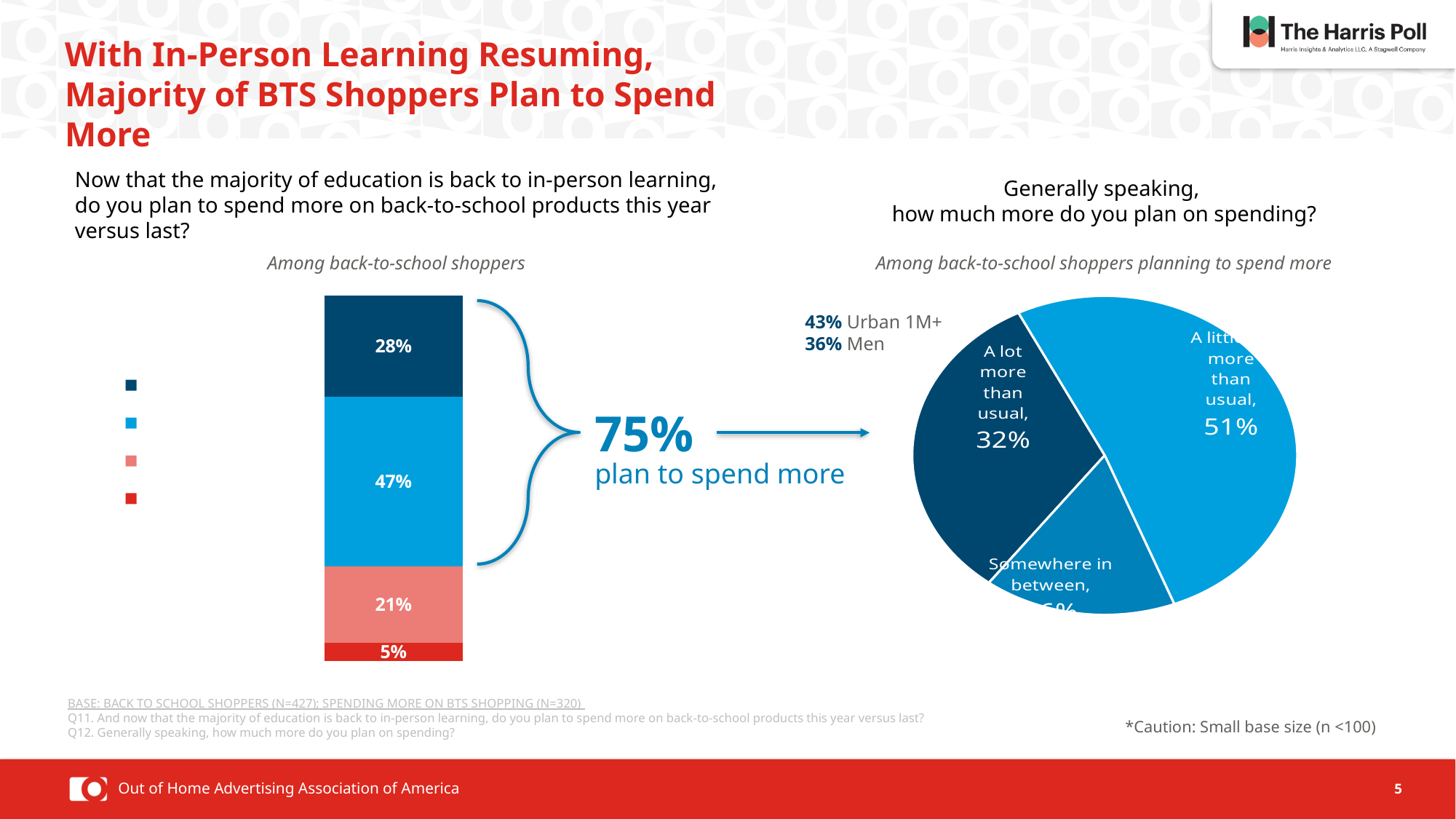
What type of chart is shown on the left side of the slide? Stacked bar chart What type of chart is shown on the right side of the slide? Pie chart In the stacked bar chart on the left, what is the value of the largest segment? 47% In the pie chart on the right, what share of shoppers plan to spend 'A little more than usual'? 51% In the stacked bar chart on the left, what is the value of the top (dark blue) segment? 28% In the pie chart on the right, what is the difference between the 'A little more than usual' slice and the 'A lot more than usual' slice? 19 percentage points In the stacked bar chart on the left, how many segments make up the bar? 4 In the pie chart on the right, which slice is the largest? A little more than usual In the stacked bar chart on the left, what is the value of the smallest segment? 5% In the stacked bar chart on the left, what is the difference between the 47% segment and the 28% segment? 19 percentage points According to the callout next to the stacked bar chart, what share of back-to-school shoppers plan to spend more? 75% In the pie chart on the right, what share of shoppers plan to spend 'A lot more than usual'? 32%